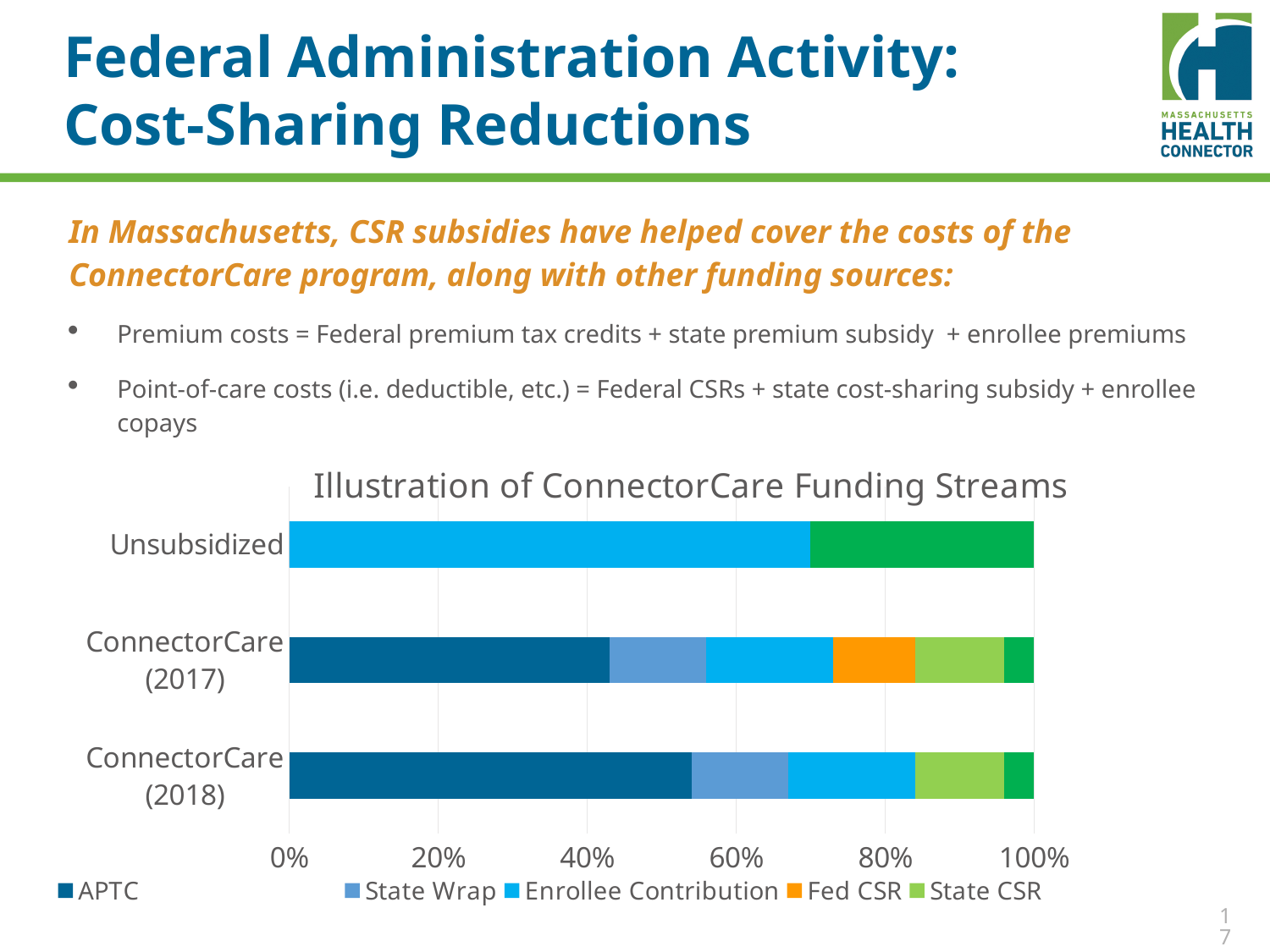
How many categories (bars) are shown in the chart? 3 Is the Enrollee Contribution share for the Unsubsidized bar greater or less than 60%? greater Which category has the largest APTC segment? ConnectorCare (2018) Which has a larger APTC share, ConnectorCare (2017) or ConnectorCare (2018)? ConnectorCare (2018) Which category has the largest Enrollee Contribution segment? Unsubsidized Is the APTC share for ConnectorCare (2017) greater or less than 60%? less What is the title of the chart? Illustration of ConnectorCare Funding Streams What kind of chart is shown on the slide? Stacked bar chart Is the APTC share for ConnectorCare (2018) greater or less than 40%? greater Which series is listed first in the chart legend? APTC How many series does the chart legend list? 5 What is the highest value shown on the x axis? 100%